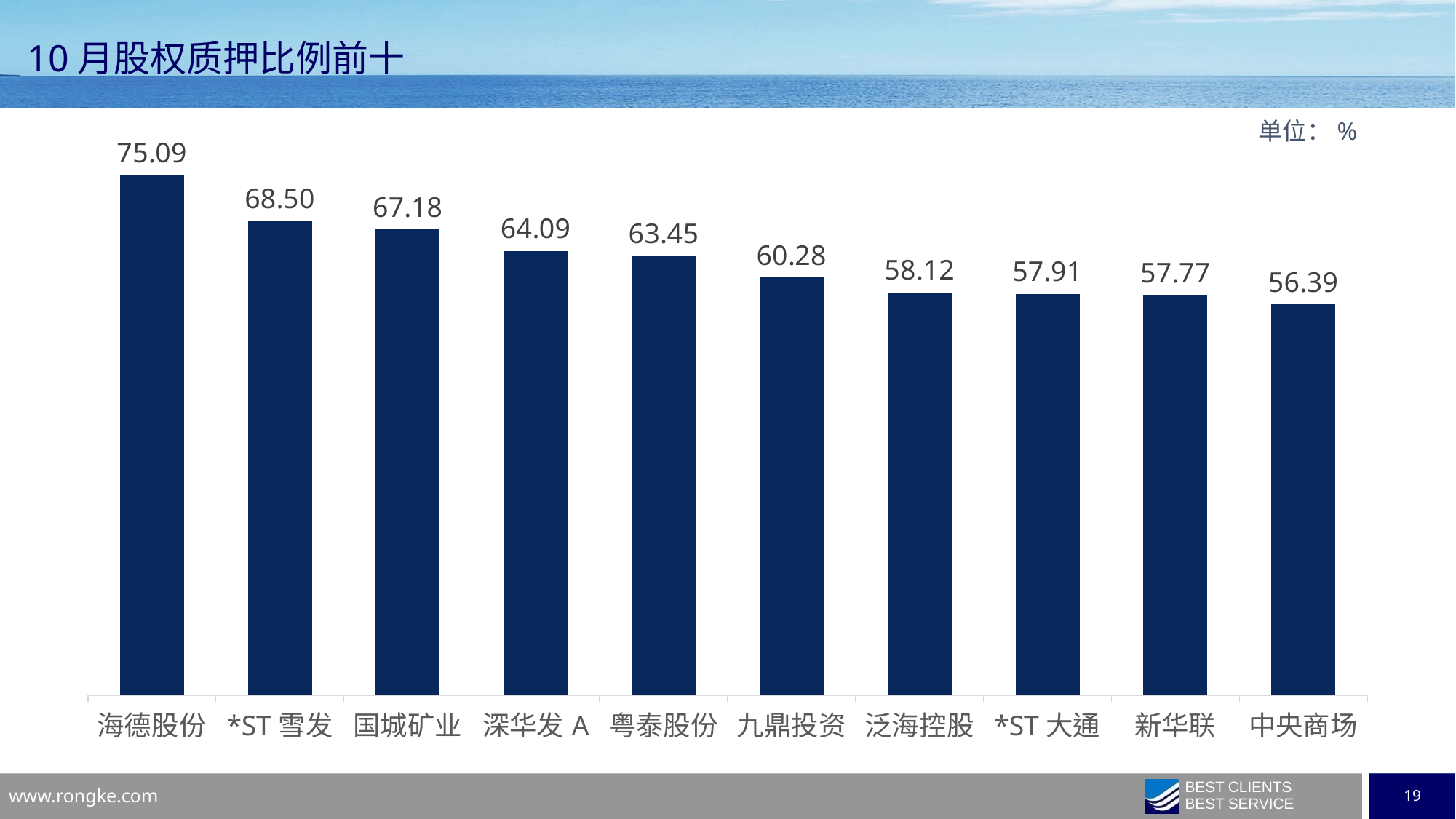
What is the value for 中央商场? 56.39 What kind of chart is this? bar chart Do the values rise or fall from left to right along the x axis? fall What is the value for 九鼎投资? 60.28 What is the difference between the values for 海德股份 and *ST 雪发? 6.59 Which company has the highest value? 海德股份 What is the value for 海德股份? 75.09 Which company has the lowest value? 中央商场 What unit is indicated for the values in the chart? % How many companies are shown in the chart? 10 Which is larger, the value for 国城矿业 or the value for 泛海控股? 国城矿业 What is the difference between the values for 深华发 A and 粤泰股份? 0.64